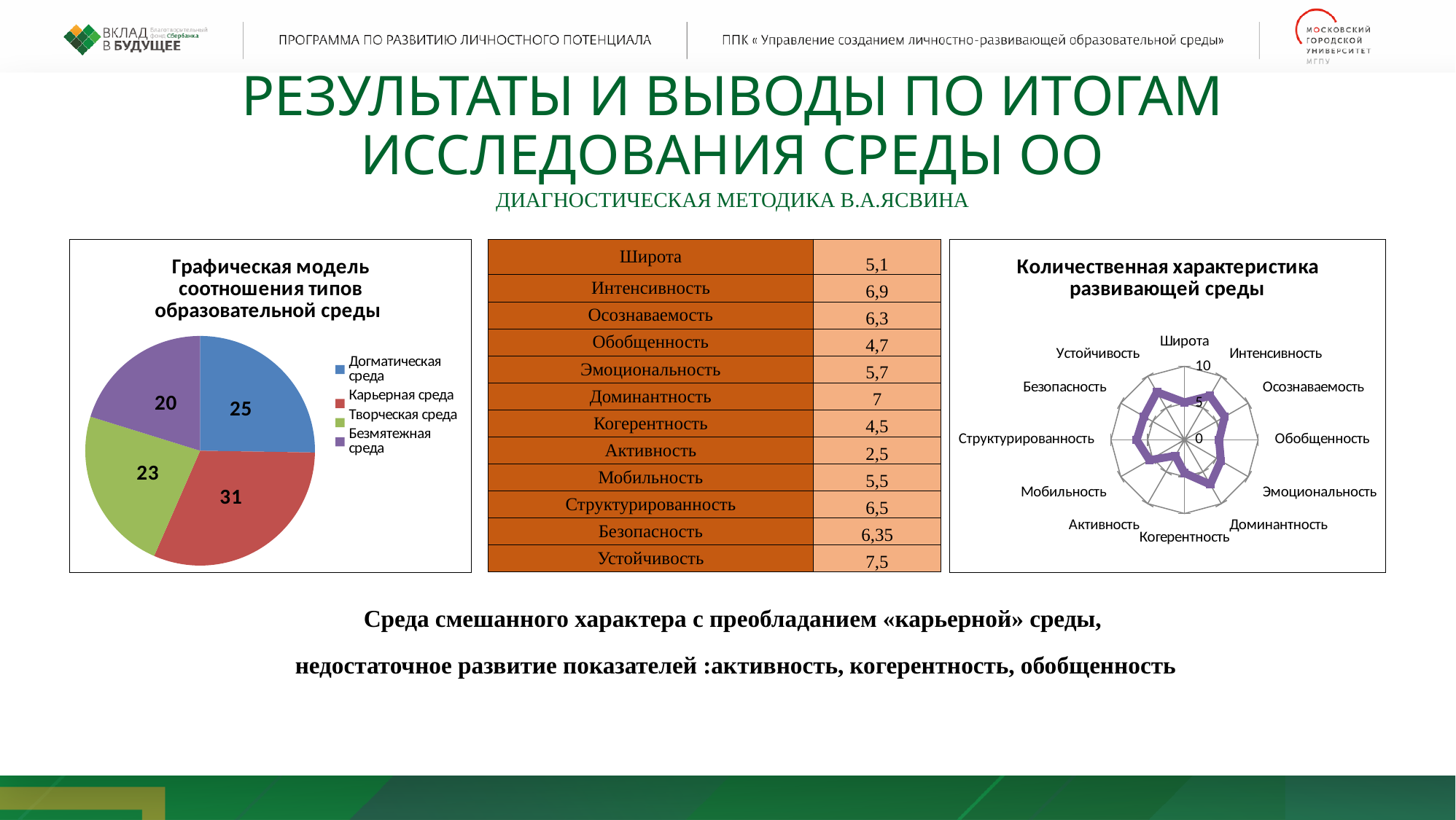
What kind of chart is the chart titled «Графическая модель соотношения типов образовательной среды»? pie chart In the radar chart «Количественная характеристика развивающей среды», is the value for Устойчивость greater or less than 5? greater In the pie chart «Графическая модель соотношения типов образовательной среды», what is the value for Безмятежная среда? 20 What kind of chart is the chart titled «Количественная характеристика развивающей среды»? radar chart How many slices does the pie chart «Графическая модель соотношения типов образовательной среды» have? 4 In the radar chart «Количественная характеристика развивающей среды», is the value for Активность greater or less than 5? less In the pie chart «Графическая модель соотношения типов образовательной среды», what colour is the slice for Творческая среда? green In the pie chart «Графическая модель соотношения типов образовательной среды», what is the difference between the values for Карьерная среда and Творческая среда? 8 In the pie chart «Графическая модель соотношения типов образовательной среды», which type of environment has the smallest slice? Безмятежная среда In the pie chart «Графическая модель соотношения типов образовательной среды», which type of environment has the largest slice? Карьерная среда In the pie chart «Графическая модель соотношения типов образовательной среды», which is larger: Догматическая среда or Творческая среда? Догматическая среда In the pie chart «Графическая модель соотношения типов образовательной среды», what is the value for Карьерная среда? 31